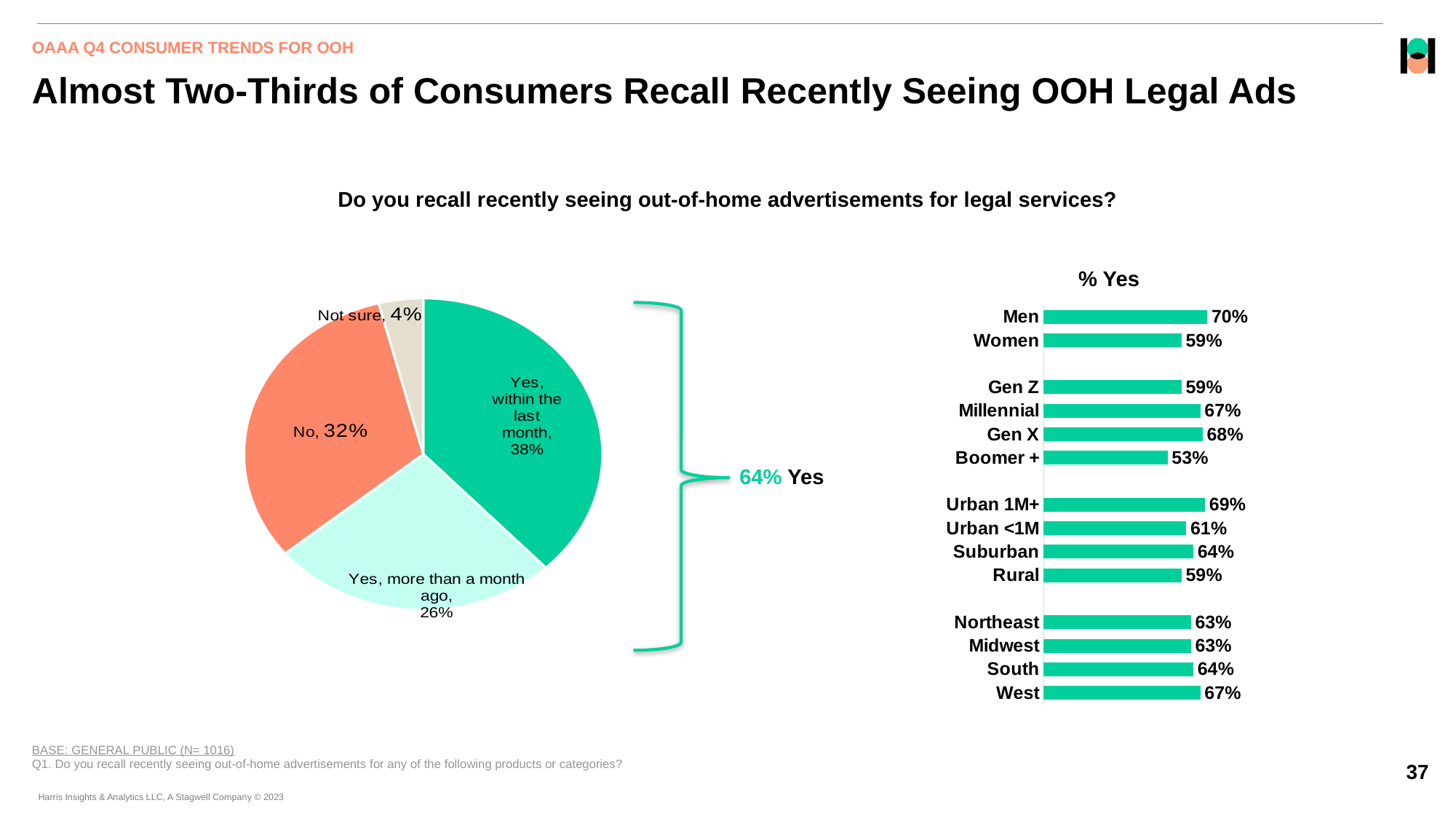
In the pie chart on the left, what is the combined share of the two "Yes" slices? 64% In the pie chart on the left, what share answered "Yes, within the last month"? 38% In the "% Yes" bar chart on the right, which category has the lowest value? Boomer + In the pie chart on the left, what share of respondents answered "No"? 32% In the "% Yes" bar chart on the right, which category has the highest value? Men In the "% Yes" bar chart on the right, which is larger, Urban 1M+ or Urban <1M? Urban 1M+ In the "% Yes" bar chart on the right, how many categories are shown? 14 In the "% Yes" bar chart on the right, what is the difference between Men and Women? 11% In the "% Yes" bar chart on the right, what is the value for Boomer +? 53% In the pie chart on the left, how many slices are there? 4 What type of chart is shown on the right side of the slide? Bar chart In the pie chart on the left, which slice is the smallest? Not sure